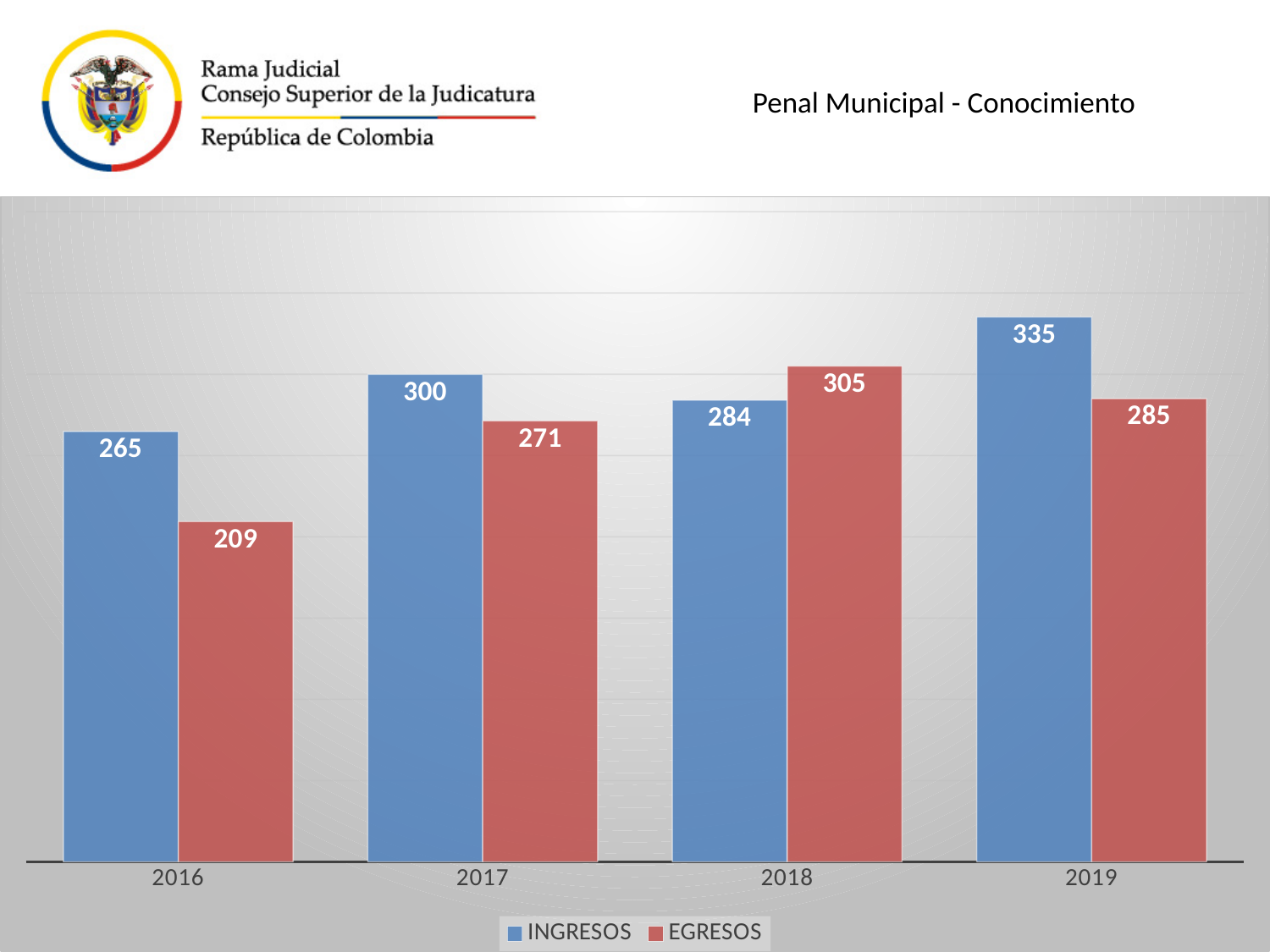
What is the title of the chart? Penal Municipal - Conocimiento How many years are shown on the x axis? 4 Which year has the highest INGRESOS value? 2019 How many series does the legend list? 2 What is the difference between INGRESOS and EGRESOS in 2016? 56 What is the difference between INGRESOS in 2019 and INGRESOS in 2018? 51 What is the EGRESOS value for 2019? 285 In 2018, which is larger, INGRESOS or EGRESOS? EGRESOS What kind of chart is shown on the slide? Bar chart Which year has the lowest EGRESOS value? 2016 What is the INGRESOS value for 2016? 265 What is the EGRESOS value for 2018? 305